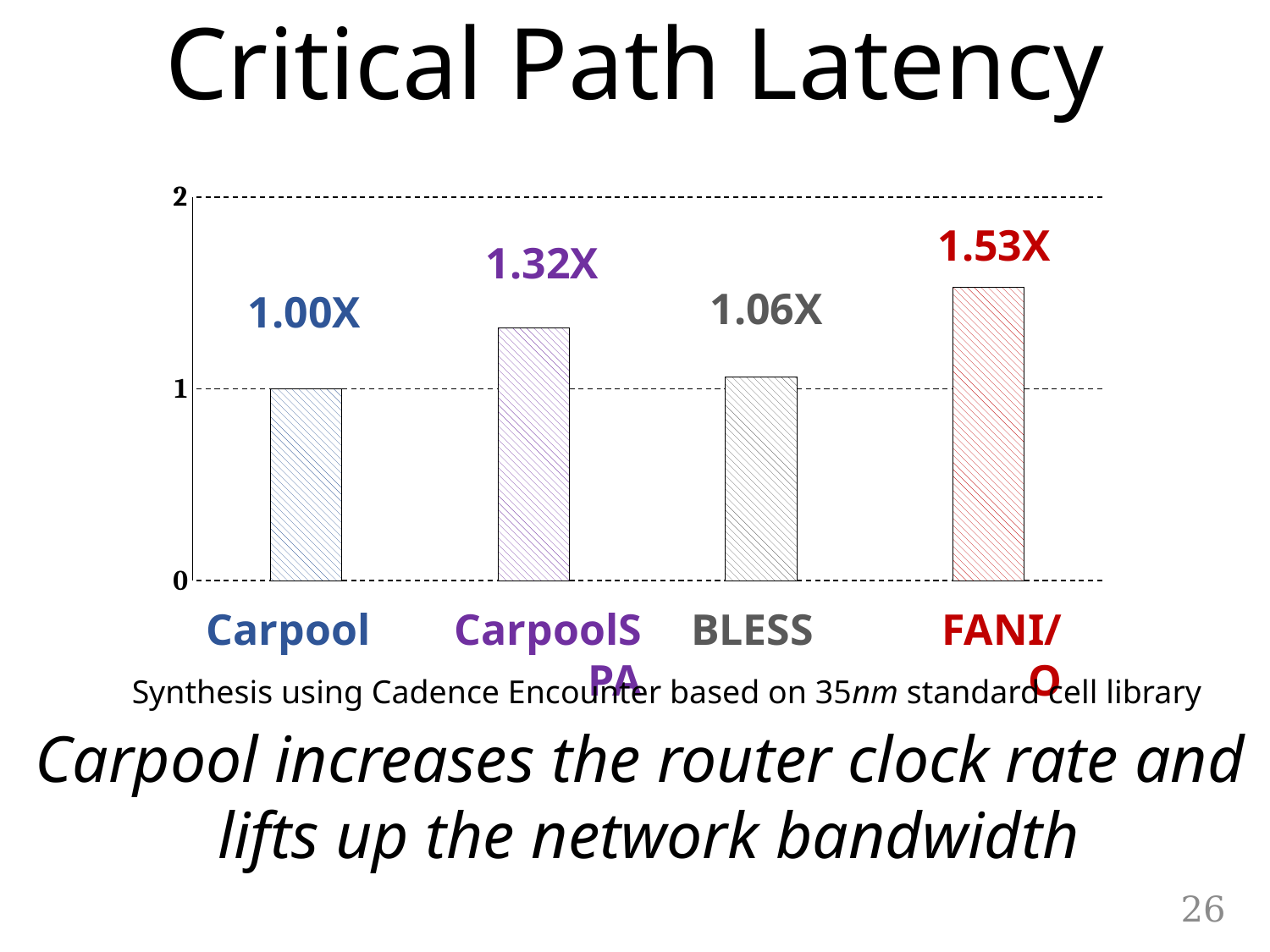
What is the difference between the FANI/O and Carpool critical path latency values? 0.53X Which router design has the highest critical path latency? FANI/O What is the critical path latency value shown for CarpoolSPA? 1.32X What kind of chart is shown on the slide? bar chart What is the title of the chart on the slide? Critical Path Latency How many router designs are compared in the chart? 4 Which router design has the lowest critical path latency? Carpool Is the value for FANI/O greater or less than 1 on the y axis? greater What is the critical path latency value shown for BLESS? 1.06X What is the critical path latency value shown for FANI/O? 1.53X Which has a higher critical path latency, CarpoolSPA or BLESS? CarpoolSPA What is the critical path latency value shown for Carpool? 1.00X